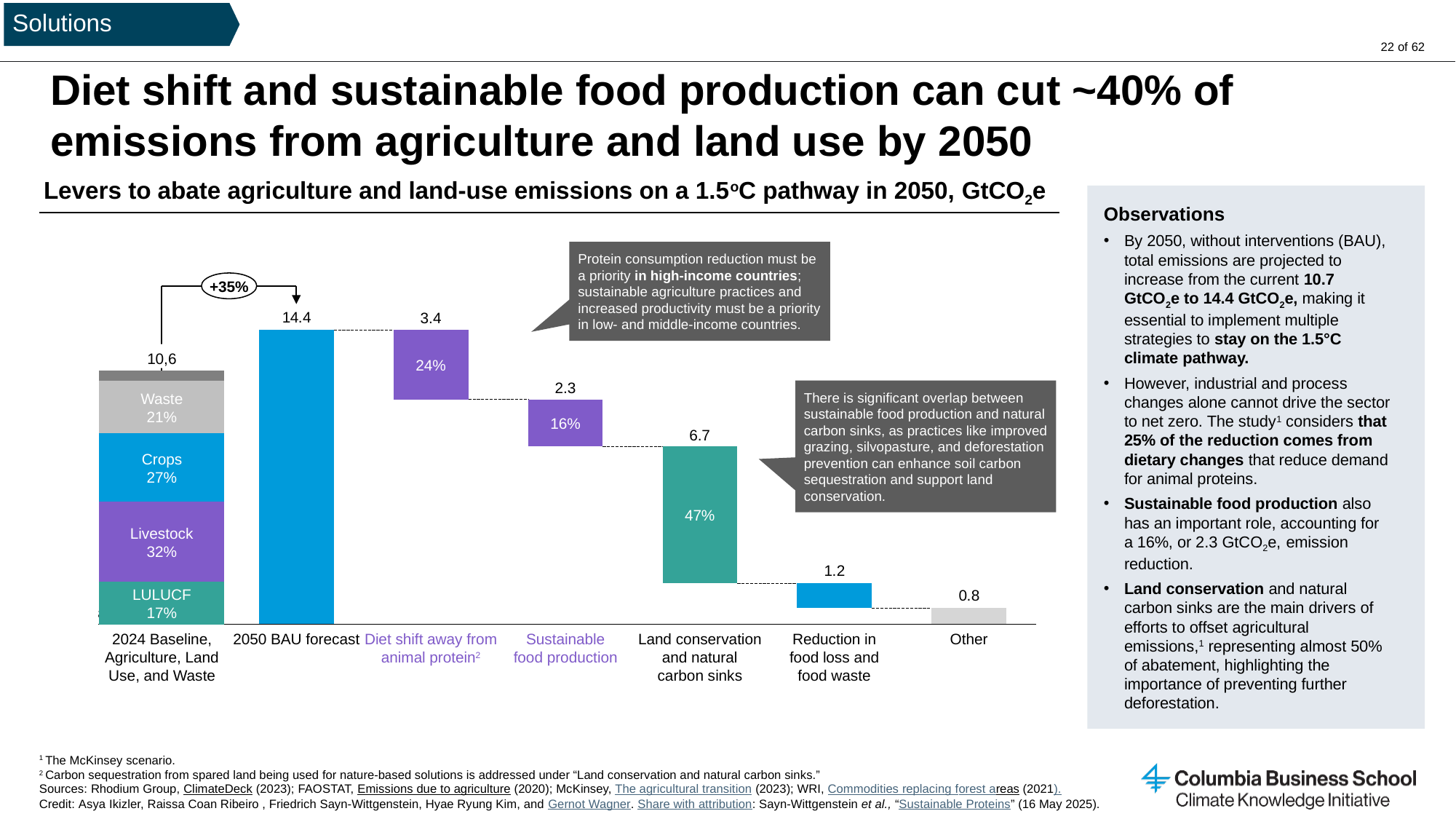
What kind of chart is shown on the slide? waterfall chart Which abatement lever has the smallest value? Other What is the value shown for Reduction in food loss and food waste? 1.2 How many bars are shown along the x axis of the chart? 7 Which abatement lever has the largest value? Land conservation and natural carbon sinks What is the difference between the Land conservation and natural carbon sinks value and the Sustainable food production value? 4.4 What percentage label is shown inside the Diet shift away from animal protein bar? 24% What percentage increase is annotated between the 2024 Baseline and the 2050 BAU forecast? +35% Which is larger, the value for Diet shift away from animal protein or the value for Sustainable food production? Diet shift away from animal protein What is the value shown for the 2050 BAU forecast bar? 14.4 What is the value shown for Land conservation and natural carbon sinks? 6.7 What share of the 2024 Baseline bar is labelled as Livestock? 32%